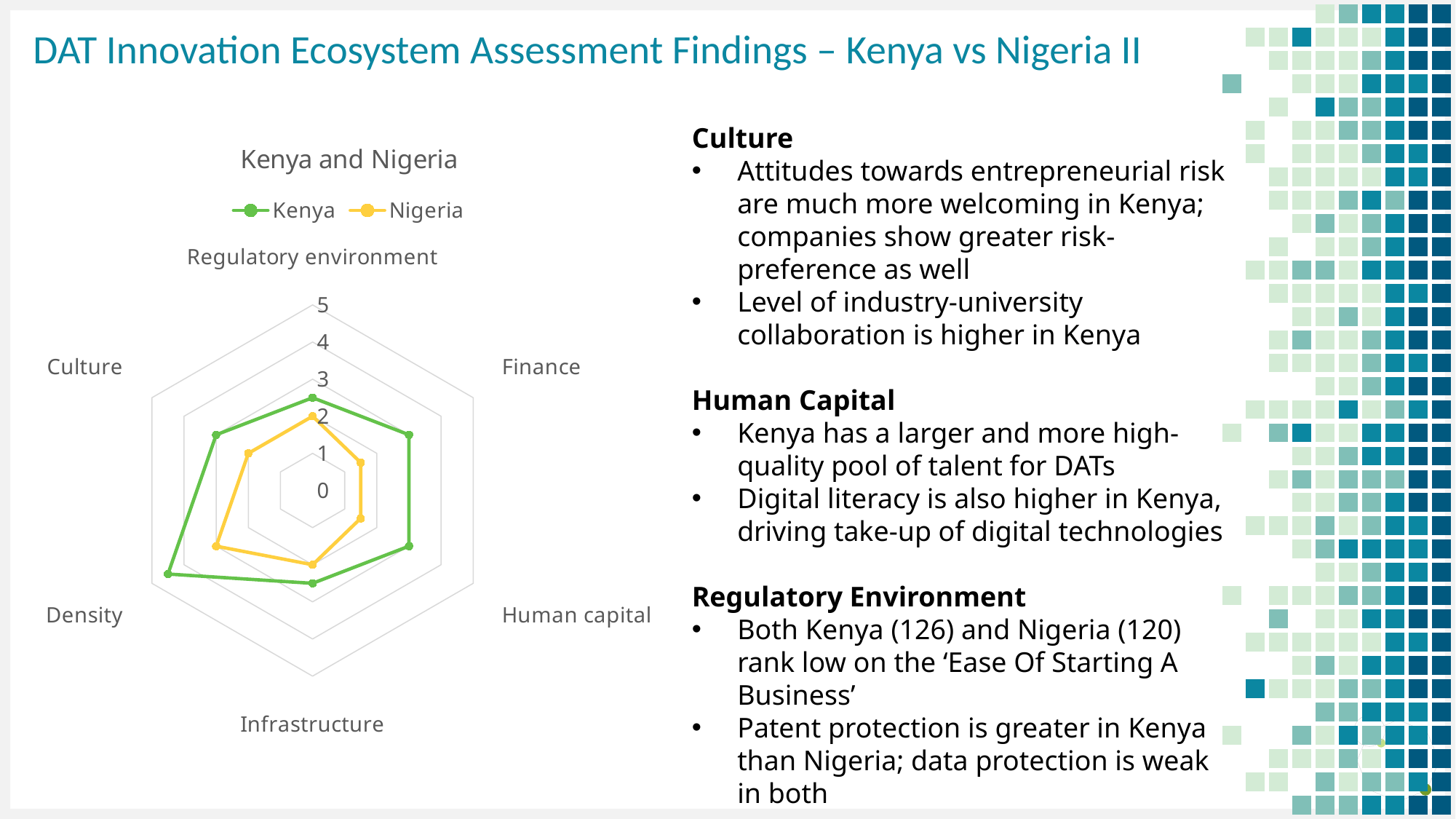
What kind of chart is shown on the slide? Radar chart Is the value for Kenya on Density greater or less than 4? greater In which category does Nigeria have its highest value? Density Which country has the higher value for Density, Kenya or Nigeria? Kenya Is the value for Kenya on Infrastructure greater or less than 3? less In which category does Kenya have its highest value? Density Which country has the higher value for Culture, Kenya or Nigeria? Kenya How many categories (axes) does the radar chart have? 6 Which colour is used for the Kenya series in the chart? Green Is the value for Nigeria on Finance greater or less than 2? less What is the title of the chart? Kenya and Nigeria How many series does the chart legend list? 2